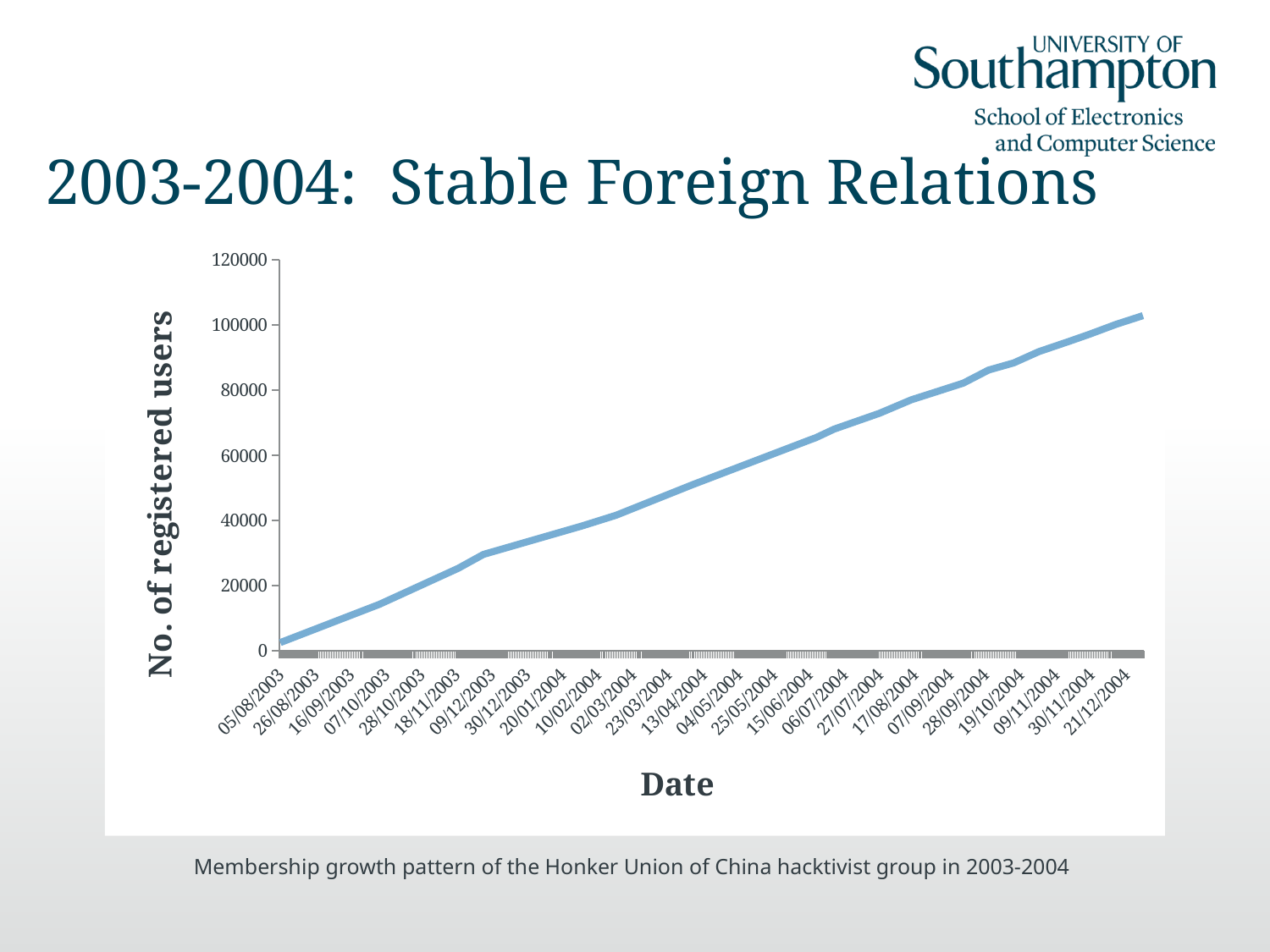
What is the title of the vertical axis? No. of registered users Is the value for 09/12/2003 greater or less than 40000? less On which date is the number of registered users lowest? 05/08/2003 Which is larger, the value for 21/12/2004 or the value for 05/08/2003? 21/12/2004 Is the value for 06/07/2004 greater or less than 60000? greater What kind of chart is shown on the slide? line chart Is the value for 21/12/2004 greater or less than 80000? greater Do the values rise or fall along the x axis from 05/08/2003 to 21/12/2004? rise